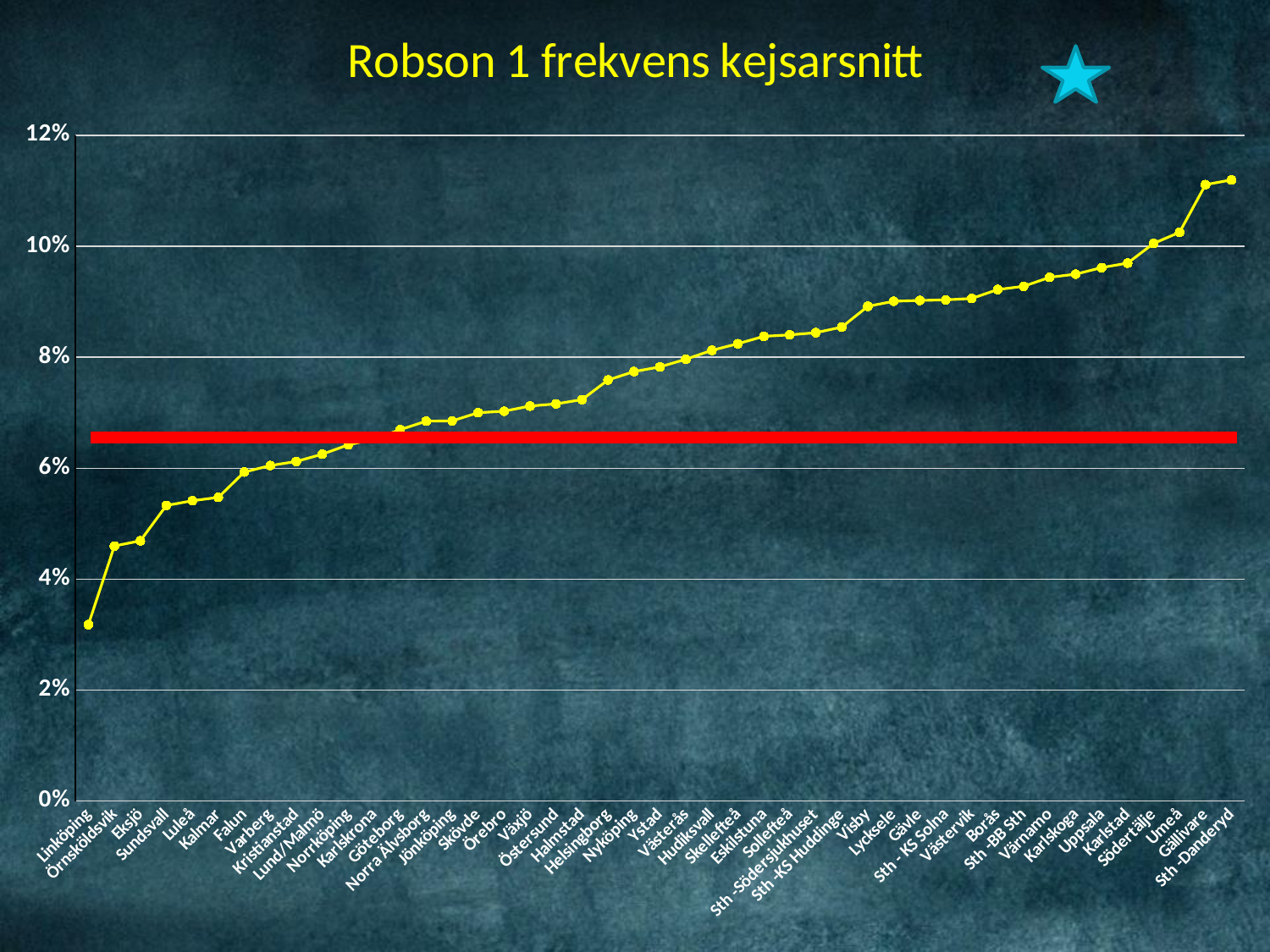
Is the value for Halmstad greater or less than 8%? less Is the value for Eksjö greater or less than 4%? greater Is the value for Kalmar greater or less than 6%? less What colour is the horizontal reference line drawn across the chart? red Do the values rise or fall from left to right along the x axis? rise Which category has the lowest value on the chart? Linköping What is the title of the chart? Robson 1 frekvens kejsarsnitt Which has the larger value, Kalmar or Visby? Visby What kind of chart is shown on the slide? line chart